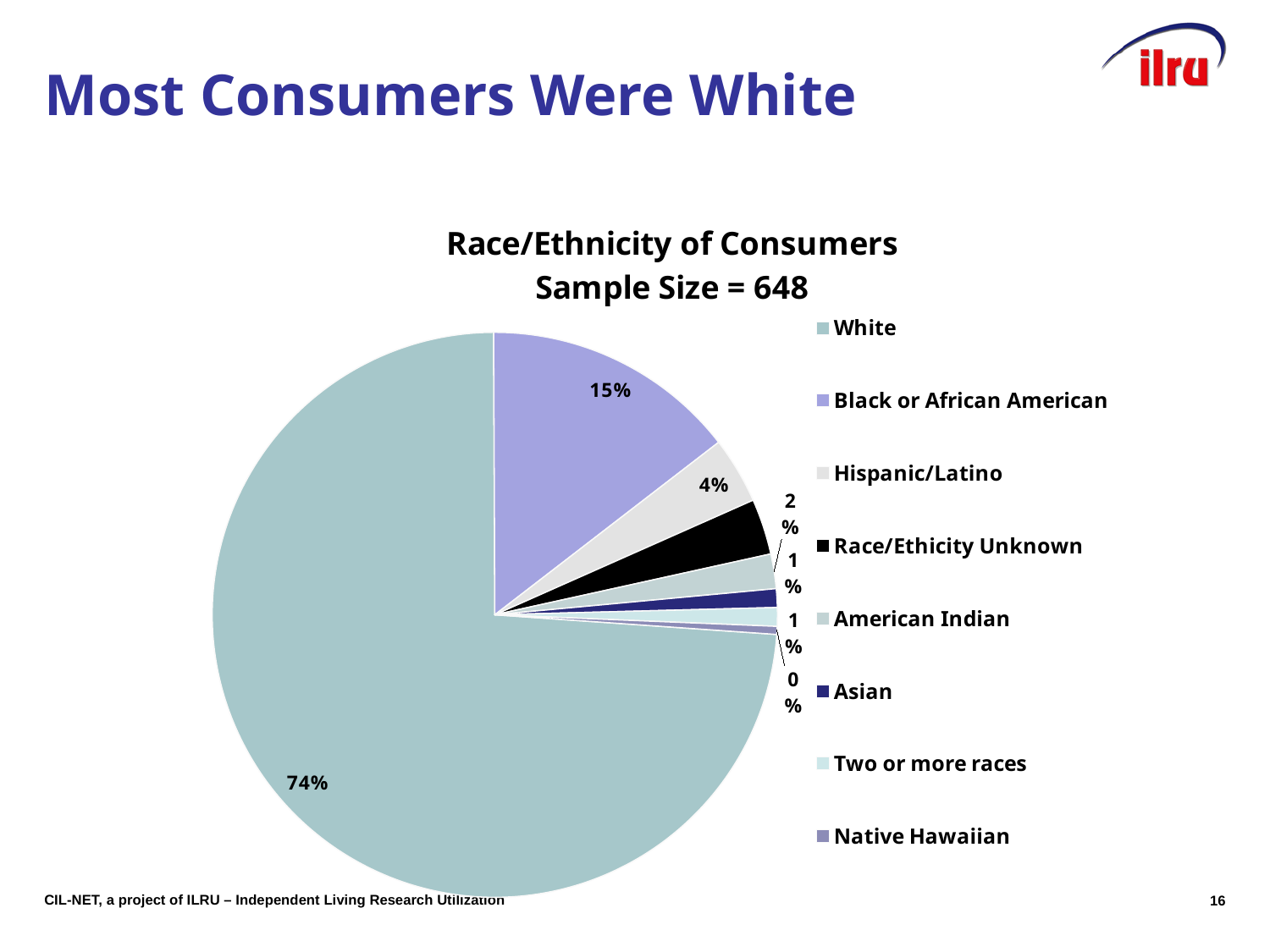
What percentage of consumers were Hispanic/Latino? 4% How many percentage points larger is the Black or African American share than the Hispanic/Latino share? 11 Which is larger, the share of Black or African American consumers or the share of Hispanic/Latino consumers? Black or African American What is the title of the chart? Race/Ethnicity of Consumers Sample Size = 648 Which race/ethnicity category has the largest share of consumers? White What percentage of consumers were Black or African American? 15% What share of consumers were White? 74% What kind of chart is shown on the slide? pie chart How many percentage points larger is the White share than the Black or African American share? 59 What is the sample size stated in the chart title? 648 How many categories does the legend of the pie chart list? 8